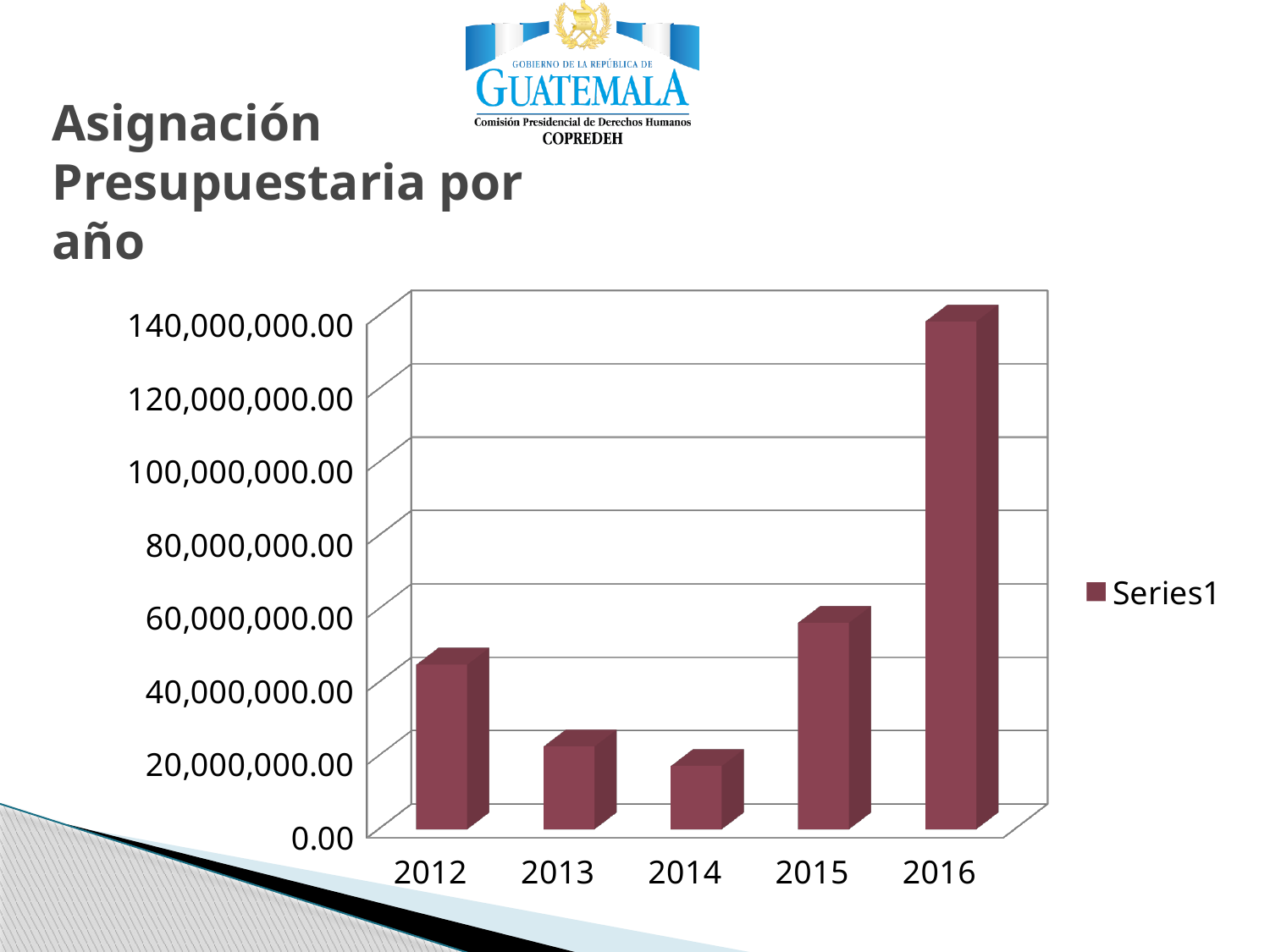
How many years are shown on the x axis of the chart? 5 Which year has the lowest budget allocation in the chart? 2014 What kind of chart is shown on the slide? bar chart Is the value for 2012 greater or less than 60,000,000.00? less Which year has a larger value, 2012 or 2015? 2015 Is the value for 2013 greater or less than 40,000,000.00? less What is the name of the series shown in the chart legend? Series1 Which year has the highest budget allocation in the chart? 2016 Do the values rise or fall from 2014 to 2016? rise Is the value for 2016 greater or less than 120,000,000.00? greater How many series does the chart legend list? 1